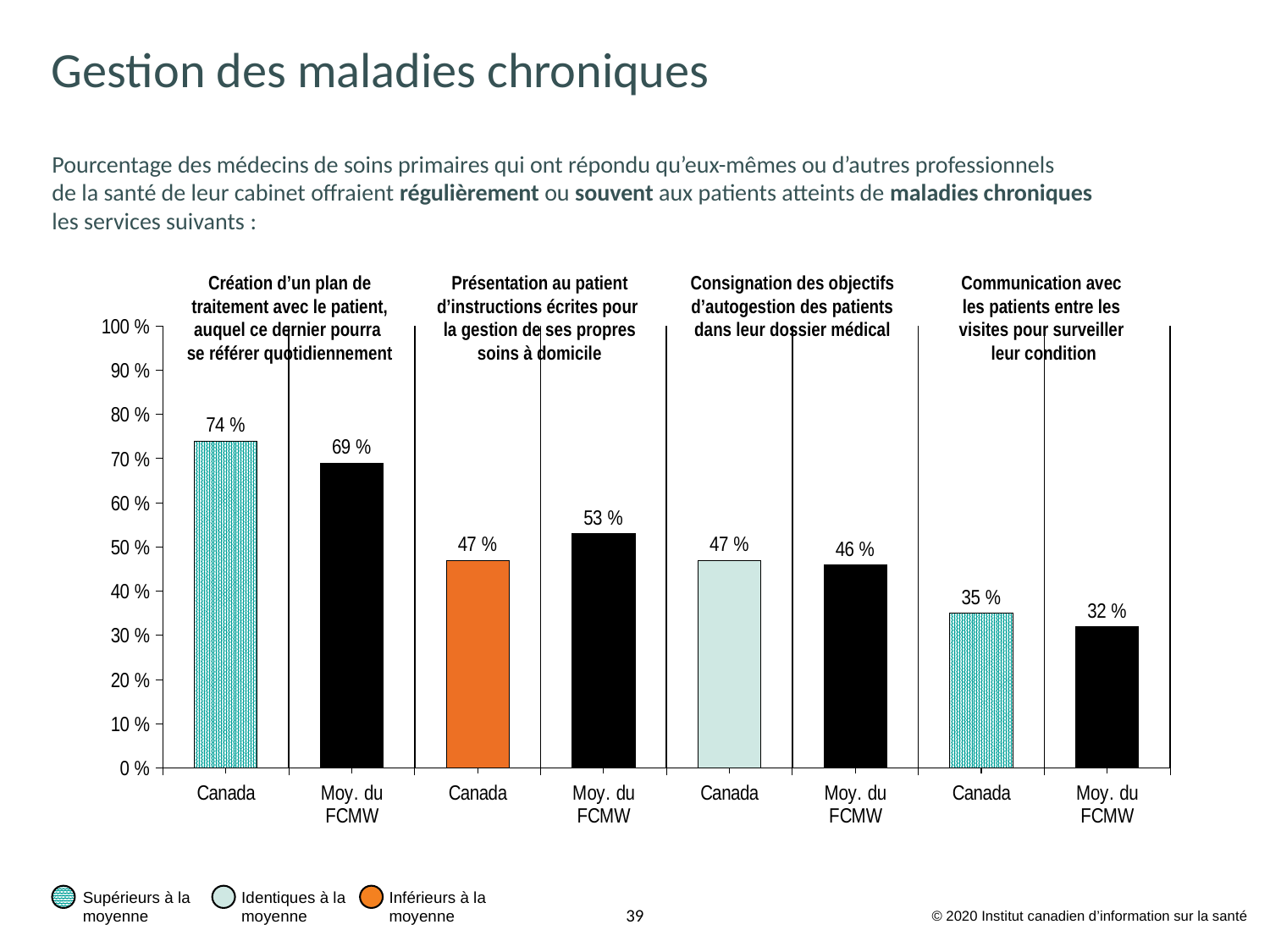
What is the difference between Moy. du FCMW and Canada for 'Présentation au patient d'instructions écrites pour la gestion de ses propres soins à domicile'? 6 % Which bar has the lowest value on the chart? Moy. du FCMW, Communication avec les patients entre les visites What is the value for Moy. du FCMW for 'Consignation des objectifs d'autogestion des patients dans leur dossier médical'? 46 % What is the value for Canada for 'Création d'un plan de traitement avec le patient, auquel ce dernier pourra se référer quotidiennement'? 74 % What is the value for Canada for 'Communication avec les patients entre les visites pour surveiller leur condition'? 35 % For 'Communication avec les patients entre les visites pour surveiller leur condition', which is larger: Canada or Moy. du FCMW? Canada Which bar has the highest value on the chart? Canada, Création d'un plan de traitement avec le patient What kind of chart is shown on the slide? Bar chart How many bars are plotted on the chart? 8 What is the value for Moy. du FCMW for 'Présentation au patient d'instructions écrites pour la gestion de ses propres soins à domicile'? 53 % What is the difference between Canada and Moy. du FCMW for 'Création d'un plan de traitement avec le patient'? 5 % According to the legend, what does the orange bar colour indicate? Inférieurs à la moyenne